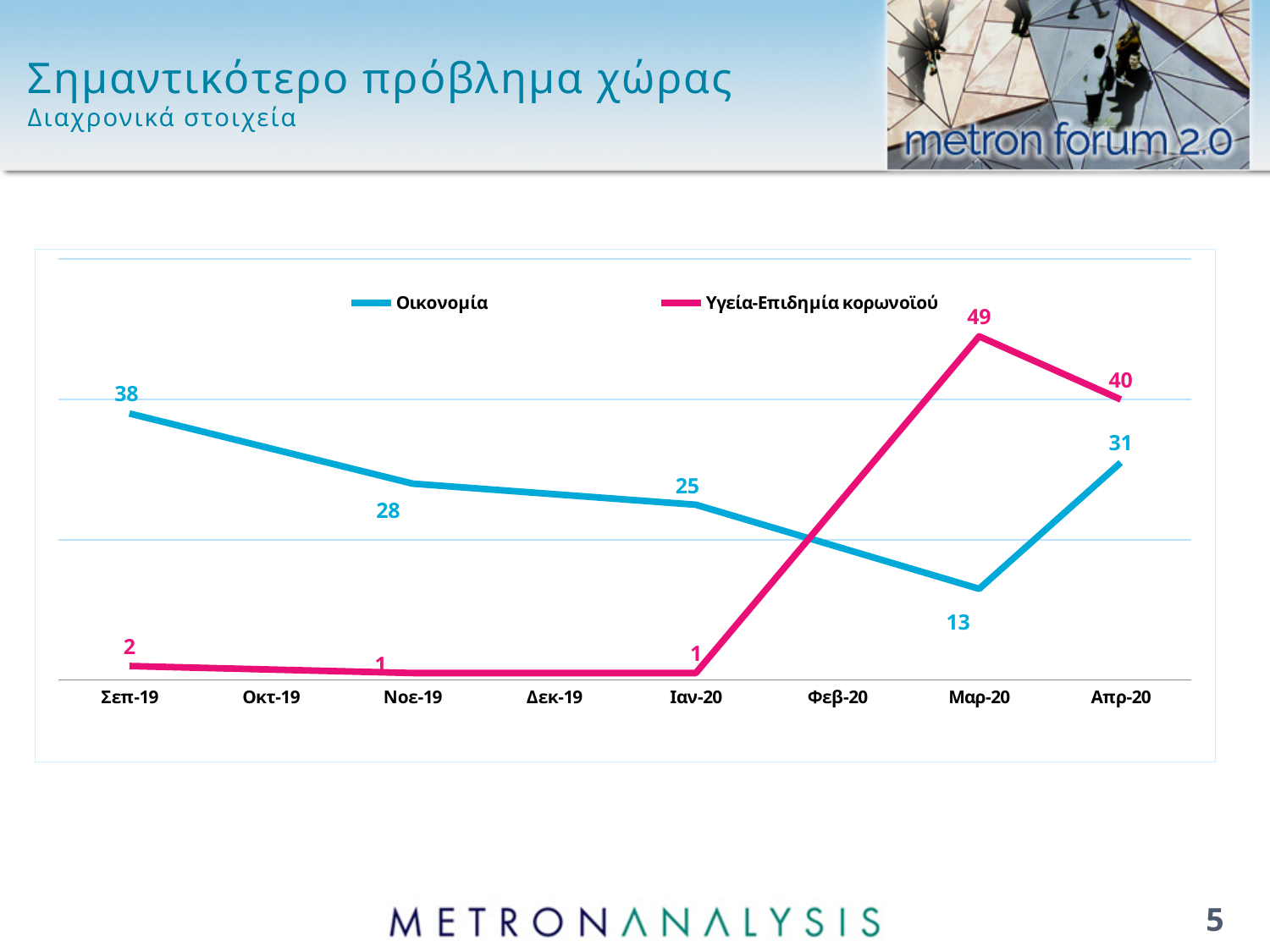
What is the difference between the Υγεία-Επιδημία κορωνοϊού value and the Οικονομία value at Μαρ-20? 36 At Απρ-20, which series has the larger value, Οικονομία or Υγεία-Επιδημία κορωνοϊού? Υγεία-Επιδημία κορωνοϊού How many categories are shown on the x axis? 8 At which x-axis category does the Οικονομία series reach its lowest labelled value? Μαρ-20 How many series does the legend list? 2 What value does the Οικονομία series have at Απρ-20? 31 What is the difference between the Οικονομία values at Σεπ-19 and Ιαν-20? 13 What value does the Υγεία-Επιδημία κορωνοϊού series have at Σεπ-19? 2 What value does the Οικονομία series have at Σεπ-19? 38 At which x-axis category does the Υγεία-Επιδημία κορωνοϊού series reach its highest value? Μαρ-20 What value does the Υγεία-Επιδημία κορωνοϊού series have at Μαρ-20? 49 What kind of chart is shown on the slide? Line chart